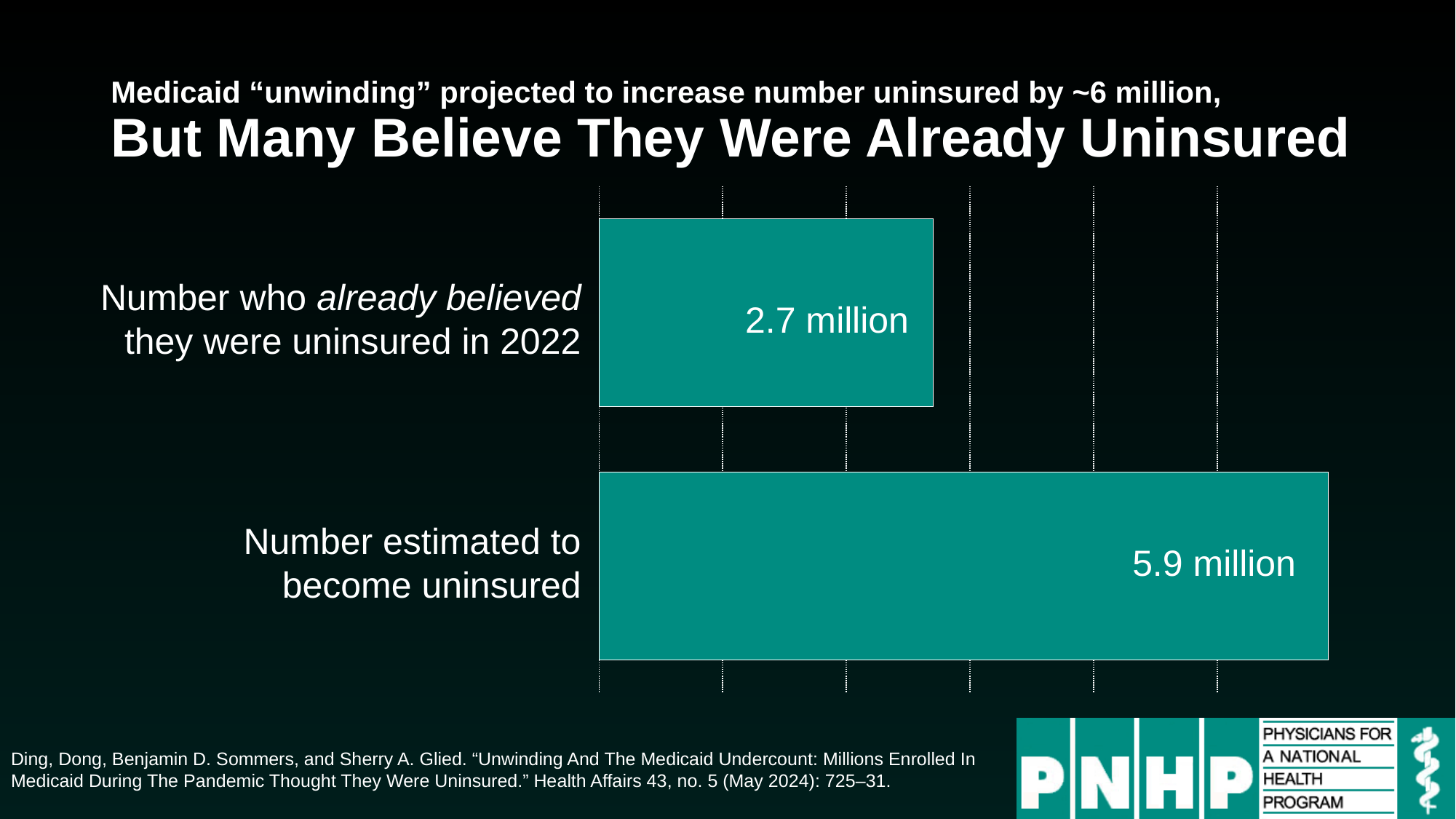
What colour are the bars in the chart? Teal Which category has the lowest value? Number who already believed they were uninsured in 2022 What is the value for "Number who already believed they were uninsured in 2022"? 2.7 million What is the value for "Number estimated to become uninsured"? 5.9 million Are the bars in the chart oriented horizontally or vertically? Horizontally What is the difference between the number estimated to become uninsured and the number who already believed they were uninsured in 2022? 3.2 million Which is larger: the number estimated to become uninsured or the number who already believed they were uninsured in 2022? Number estimated to become uninsured How many categories are shown in the chart? 2 What kind of chart is shown on the slide? Bar chart Which category has the highest value? Number estimated to become uninsured